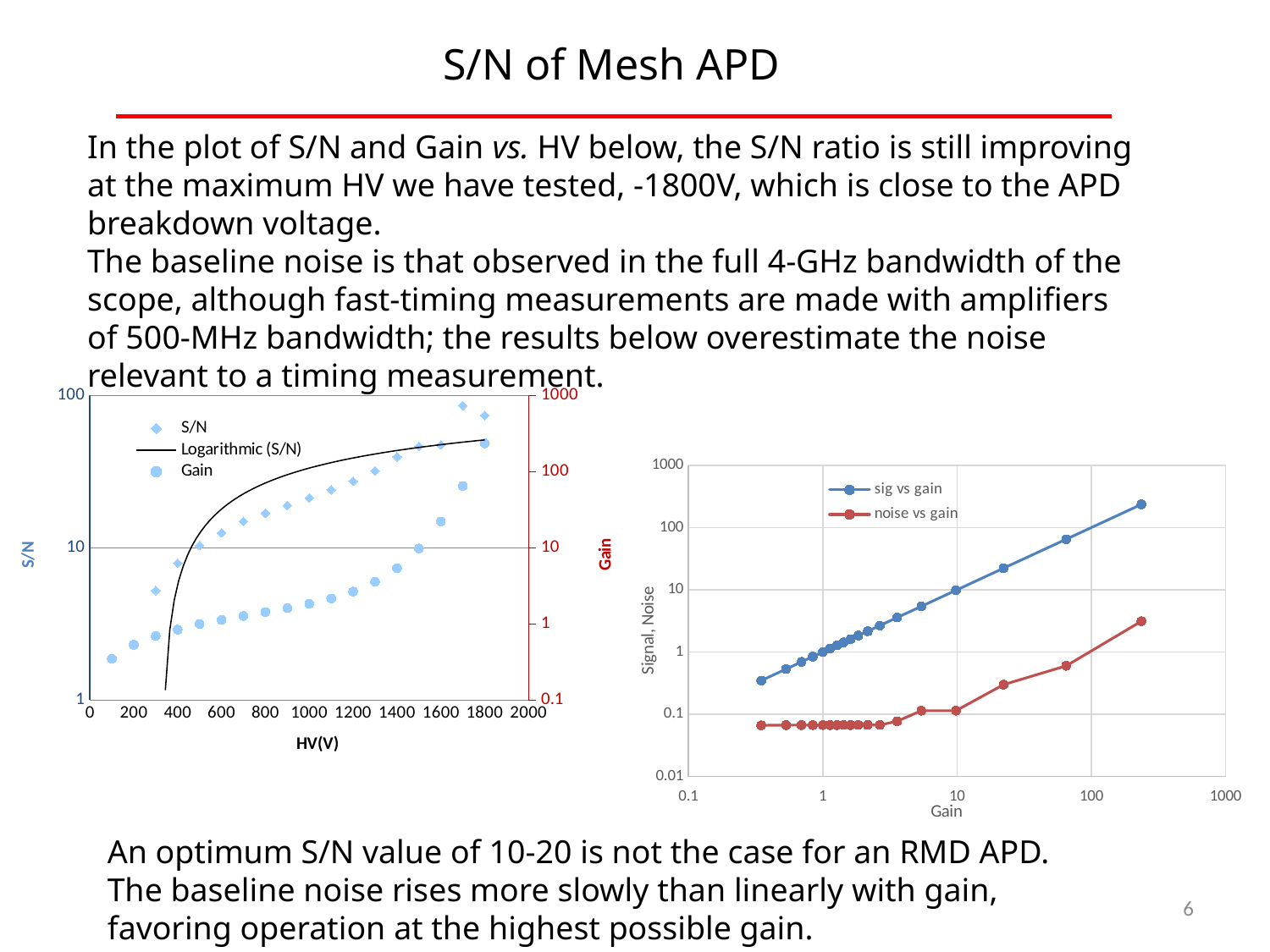
In the left chart, is the Gain value at 1800 V greater or less than 100? greater How many entries does the legend of the left chart list? 3 In the right chart, does the noise vs gain series rise or fall as gain increases? rise In the right chart, is the noise vs gain value at a gain of 1 greater or less than 0.1? less In the left chart, is the S/N value at 1800 V greater or less than 10? greater How many series does the legend of the right chart list? 2 What kind of chart is the right chart (Signal, Noise vs Gain)? line chart What kind of chart is the left chart (S/N and Gain vs HV)? scatter chart In the right chart, at a gain of 10, which series has the larger value, sig vs gain or noise vs gain? sig vs gain In the left chart, does S/N rise or fall as HV increases? rise What is the x-axis title of the left chart? HV(V)